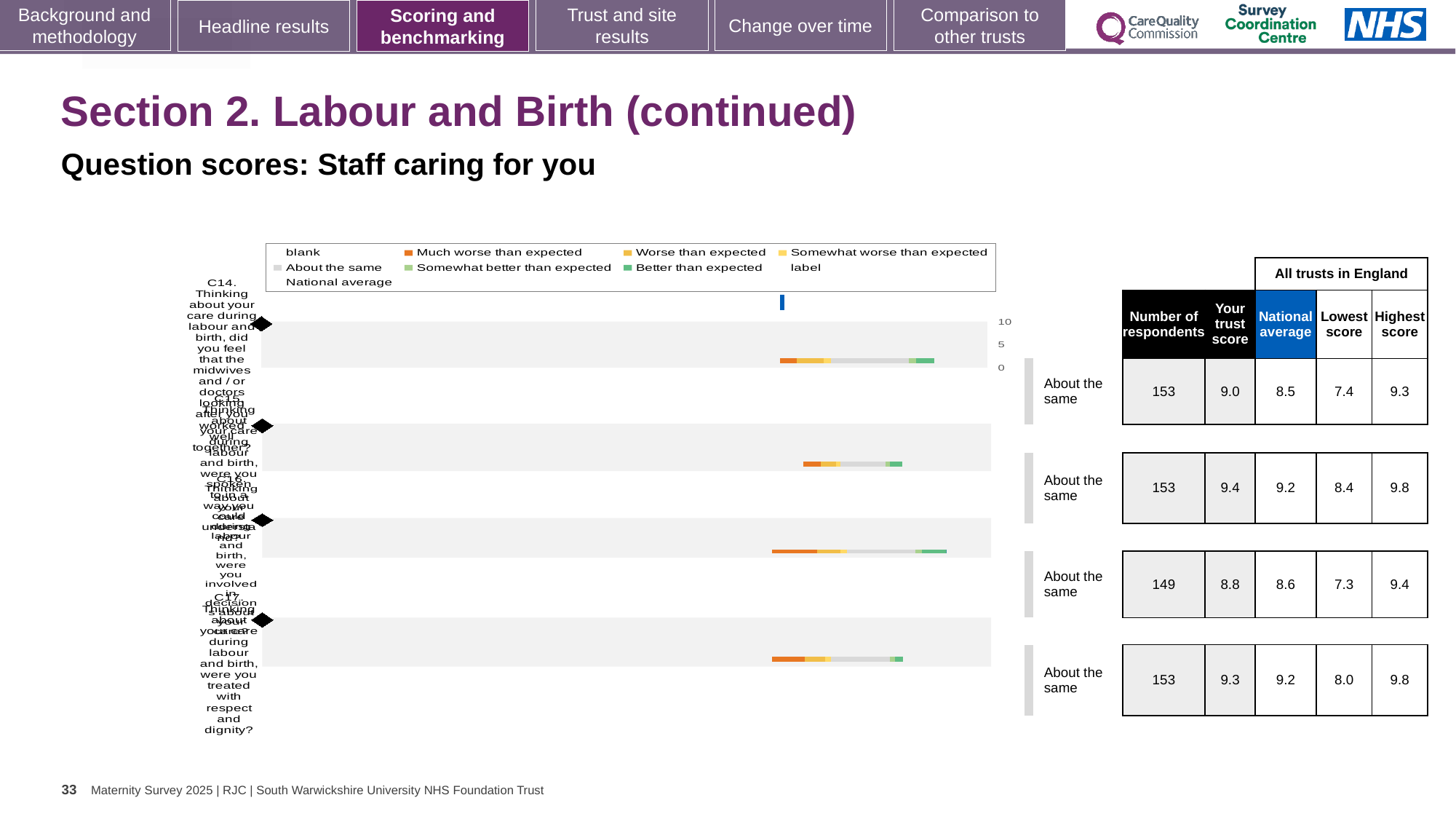
In the table beside the chart, which row has the lowest number of respondents? third row (C16), 149 In the table beside the chart, which row has the highest 'Your trust score'? second row (C15), 9.4 In the table beside the chart, for the third row (C16), is 'Your trust score' or the national average larger? Your trust score (8.8) In the table beside the chart, what is 'Your trust score' for the first row (C14)? 9.0 What colour does the legend use for 'Better than expected'? green In the table beside the chart, what is the number of respondents for the third row (C16)? 149 In the table beside the chart, what is the difference between 'Your trust score' and the national average for the first row (C14)? 0.5 How many horizontal bars (question rows) are plotted in the chart? 4 In the table beside the chart, what is the national average for the second row (C15)? 9.2 What kind of chart is shown on the slide? bar chart What colour does the legend use for 'Much worse than expected'? orange In the table beside the chart, what is the lowest score for the fourth row (C17)? 8.0